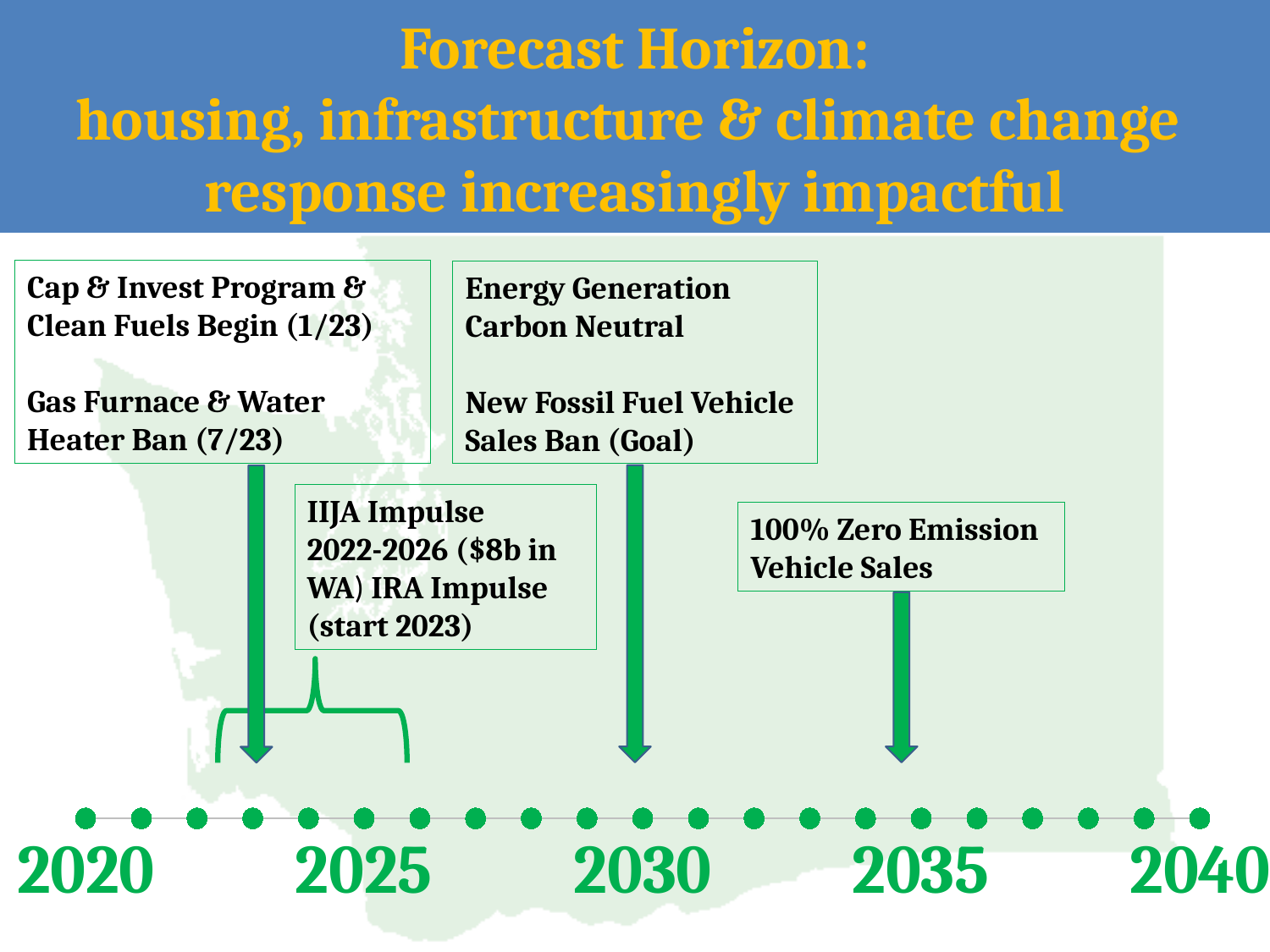
What dollar amount for WA is given for the IIJA Impulse on the timeline? $8b What is the earliest year labeled on the timeline axis? 2020 How many year labels are printed along the timeline axis? 5 What kind of chart is shown on the slide? timeline What year range is given for the IIJA Impulse on the timeline? 2022-2026 What is the latest year labeled on the timeline axis? 2040 What is the interval between consecutive year labels on the timeline axis? 5 years Which event on the timeline is placed at the latest year: the Gas Furnace & Water Heater Ban or 100% Zero Emission Vehicle Sales? 100% Zero Emission Vehicle Sales According to the timeline, in what month and year does the Gas Furnace & Water Heater Ban take effect? 7/23